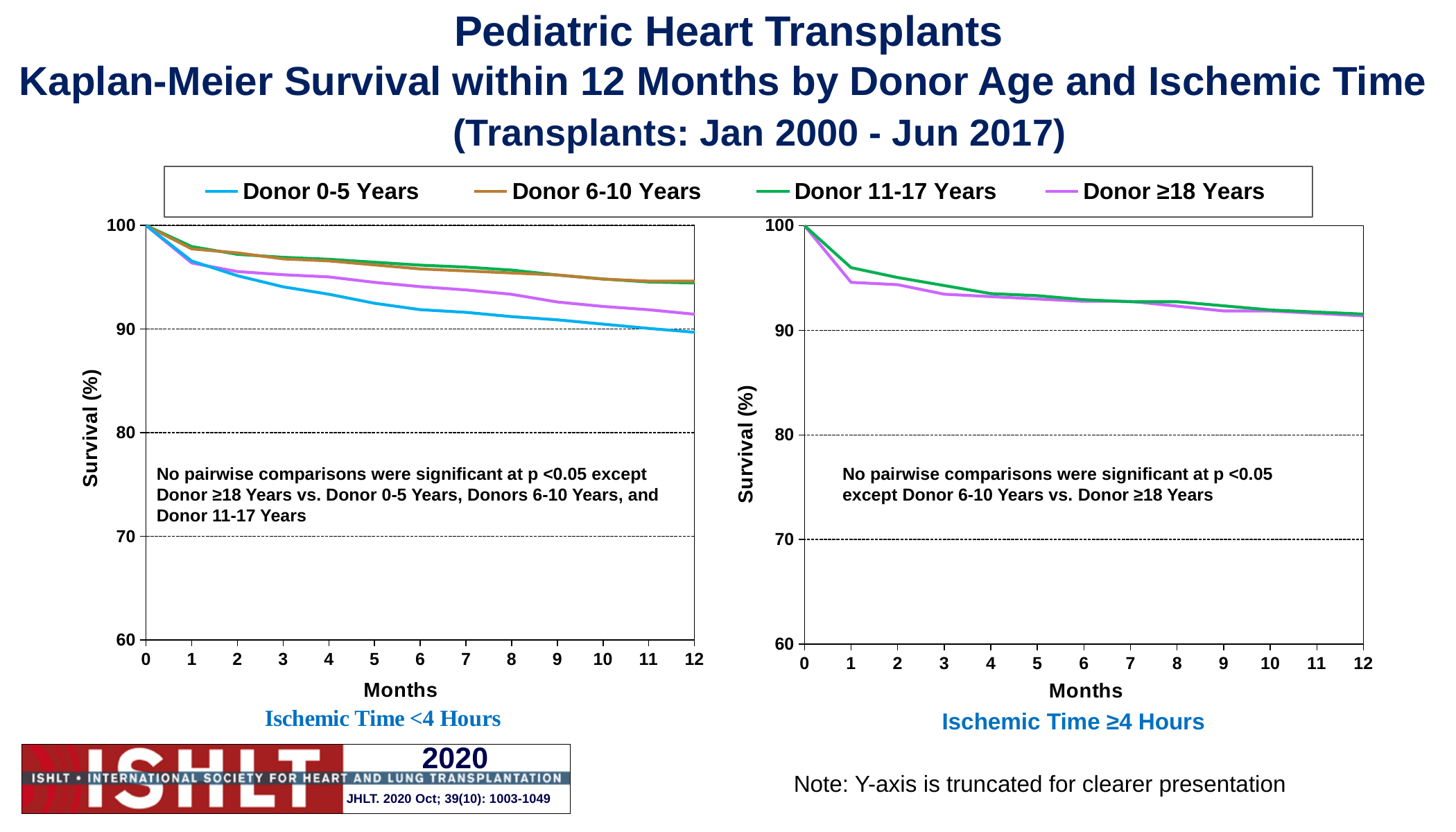
What colour is the line for Donor 0-5 Years in the legend? blue What kind of chart is the 'Ischemic Time <4 Hours' chart? line chart In the 'Ischemic Time ≥4 Hours' chart, is the survival for Donor 11-17 Years at 12 months greater or less than 90? greater How many month ticks are labelled on the x axis of the 'Ischemic Time <4 Hours' chart? 13 In the 'Ischemic Time ≥4 Hours' chart, do the survival curves rise or fall as months increase? fall How many series does the legend list? 4 In the 'Ischemic Time <4 Hours' chart, what is the survival for Donor 0-5 Years at month 0? 100 In the 'Ischemic Time <4 Hours' chart, which donor age group has the lowest survival at 12 months? Donor 0-5 Years In the 'Ischemic Time <4 Hours' chart, is the survival for Donor 6-10 Years at 12 months greater or less than 90? greater In the 'Ischemic Time <4 Hours' chart, at month 6, which is higher: Donor 0-5 Years or Donor ≥18 Years? Donor ≥18 Years What is the y-axis label of the 'Ischemic Time ≥4 Hours' chart? Survival (%) In the 'Ischemic Time <4 Hours' chart, is the survival for Donor ≥18 Years at 12 months greater or less than 90? greater